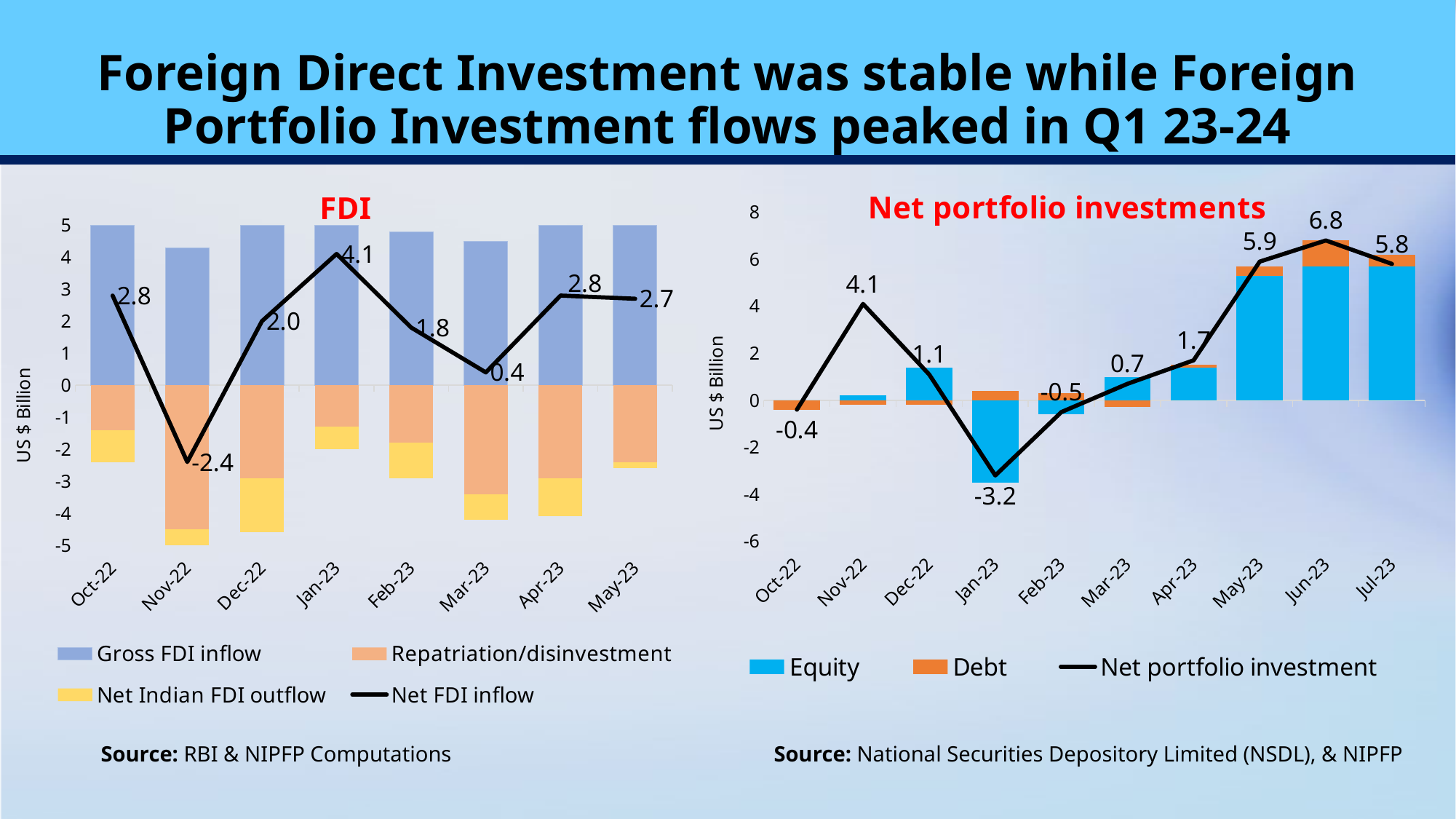
In the Net portfolio investments chart, how many months are shown on the x axis? 10 In the Net portfolio investments chart, what is the Net portfolio investment for Jun-23? 6.8 In the Net portfolio investments chart, is the Equity bar for Jun-23 greater or less than 4? greater In the FDI chart, which month has the highest Net FDI inflow? Jan-23 In the Net portfolio investments chart, what is the difference between the Net portfolio investment in Jun-23 and May-23? 0.9 In the Net portfolio investments chart, which month has the lowest Net portfolio investment? Jan-23 In the FDI chart, what is the Net FDI inflow for Jan-23? 4.1 In the FDI chart, what is the difference between the Net FDI inflow in Jan-23 and Mar-23? 3.7 In the FDI chart, which month has the lowest Net FDI inflow? Nov-22 In the FDI chart, how many months are shown on the x axis? 8 In the Net portfolio investments chart, which is larger, the Net portfolio investment in Nov-22 or in Dec-22? Nov-22 In the FDI chart, how many series does the legend list? 4